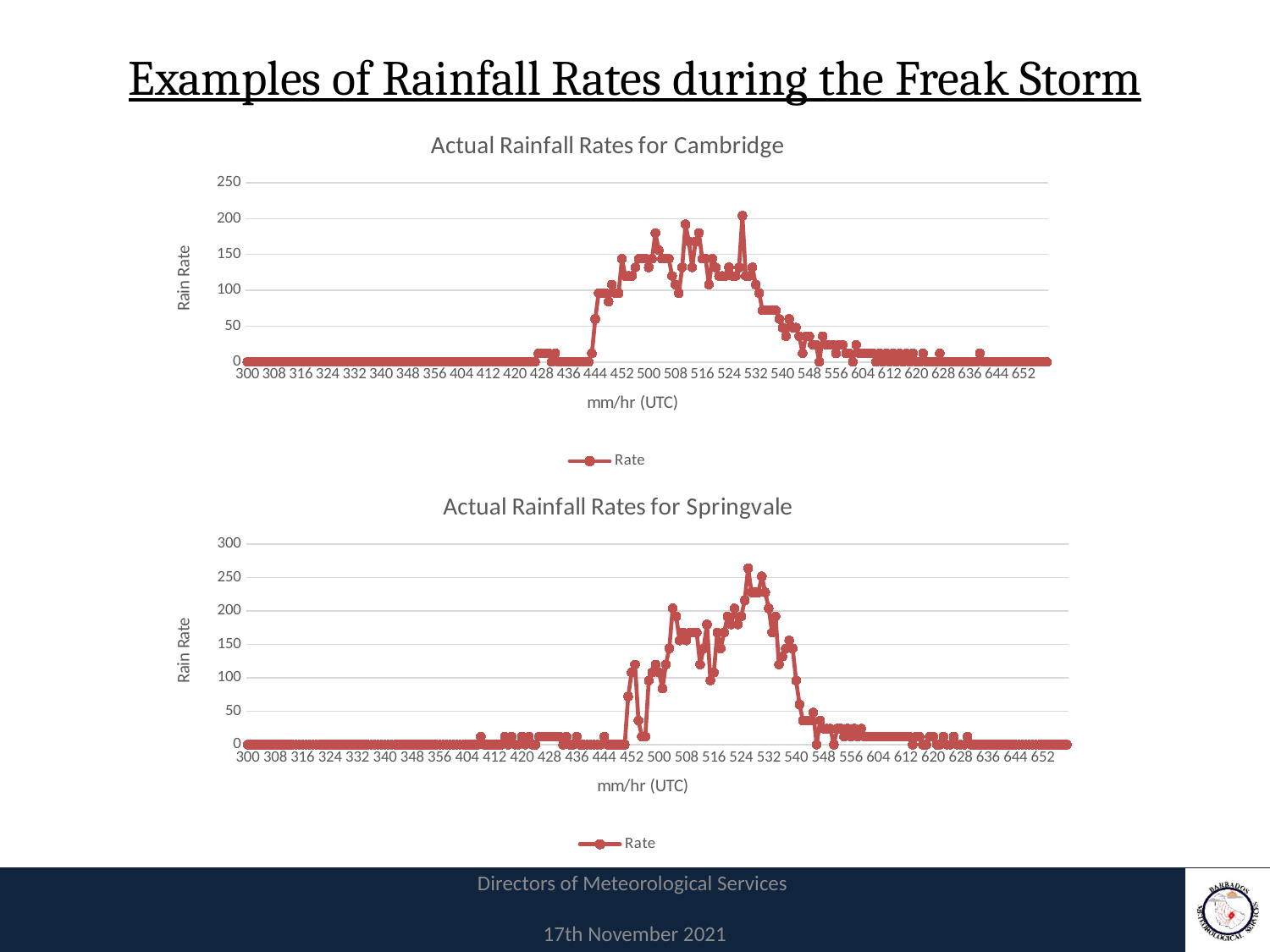
In the 'Actual Rainfall Rates for Springvale' chart, is the value at 652 greater or less than 50? less What kind of chart is the 'Actual Rainfall Rates for Cambridge' chart? line chart In the 'Actual Rainfall Rates for Cambridge' chart, is the value at 404 greater or less than 100? less What kind of chart is the 'Actual Rainfall Rates for Springvale' chart? line chart How many series does the legend of the 'Actual Rainfall Rates for Cambridge' chart list? 1 What is the name of the series shown in the legend of the 'Actual Rainfall Rates for Springvale' chart? Rate In the 'Actual Rainfall Rates for Springvale' chart, is the highest plotted value greater or less than 200? greater What is the y-axis label on the 'Actual Rainfall Rates for Cambridge' chart? Rain Rate What is the highest value shown on the y-axis of the 'Actual Rainfall Rates for Springvale' chart? 300 Which chart reaches a higher peak rain rate, the Cambridge chart or the Springvale chart? Springvale